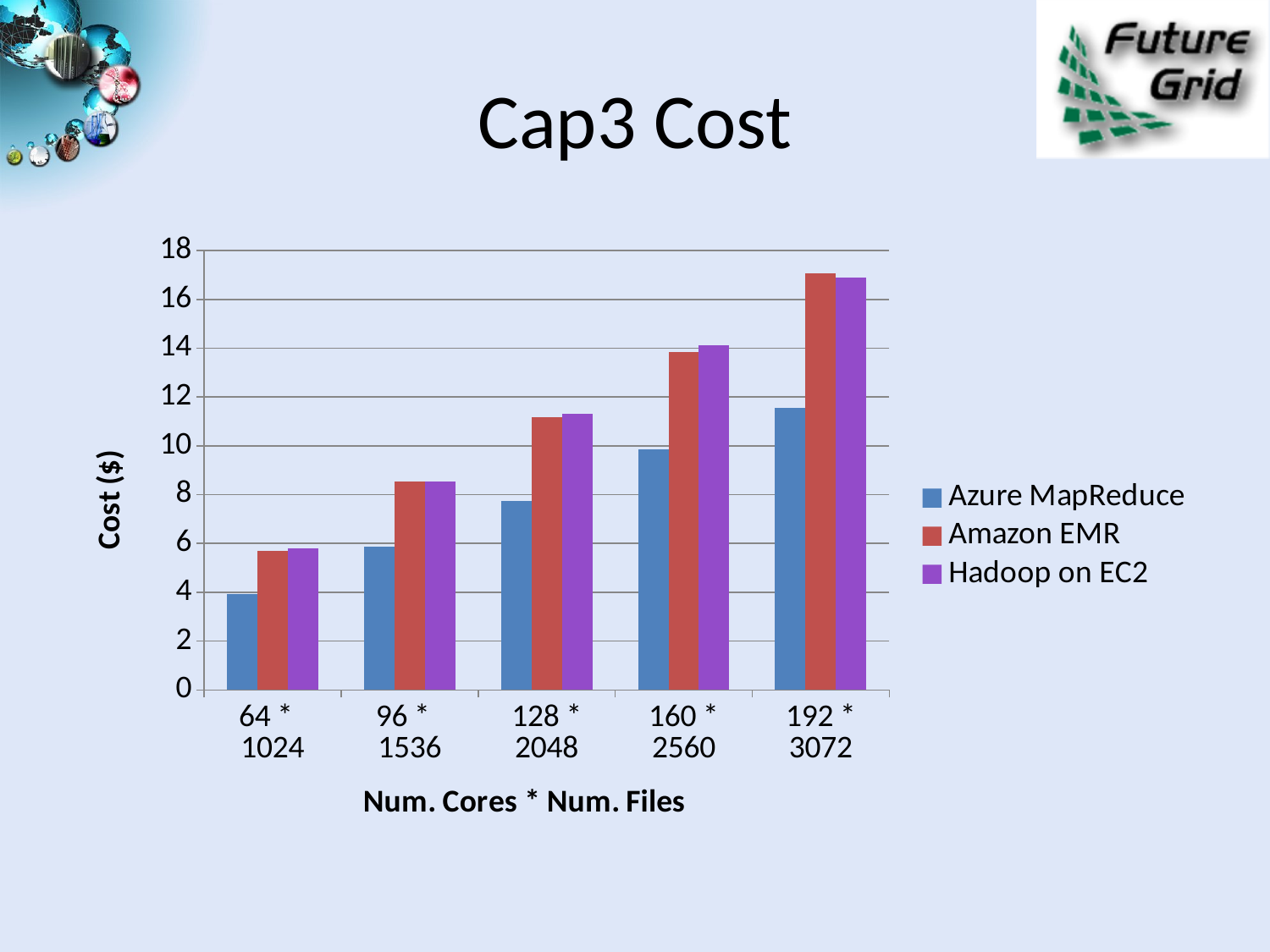
For which category is the Amazon EMR cost lowest? 64 * 1024 Do the Azure MapReduce values rise or fall as you move from 64 * 1024 to 192 * 3072 along the x axis? rise Is the Amazon EMR cost at 128 * 2048 greater or less than 10? greater What is the title of the y axis? Cost ($) How many series does the legend list? 3 At 160 * 2560, which is larger: the Azure MapReduce cost or the Amazon EMR cost? Amazon EMR Which series has the lowest cost at 192 * 3072? Azure MapReduce What kind of chart is shown on the slide? bar chart For which category is the Azure MapReduce cost highest? 192 * 3072 Is the Azure MapReduce cost at 192 * 3072 greater or less than 10? greater Is the Hadoop on EC2 cost at 96 * 1536 greater or less than 10? less How many categories are shown on the x axis? 5